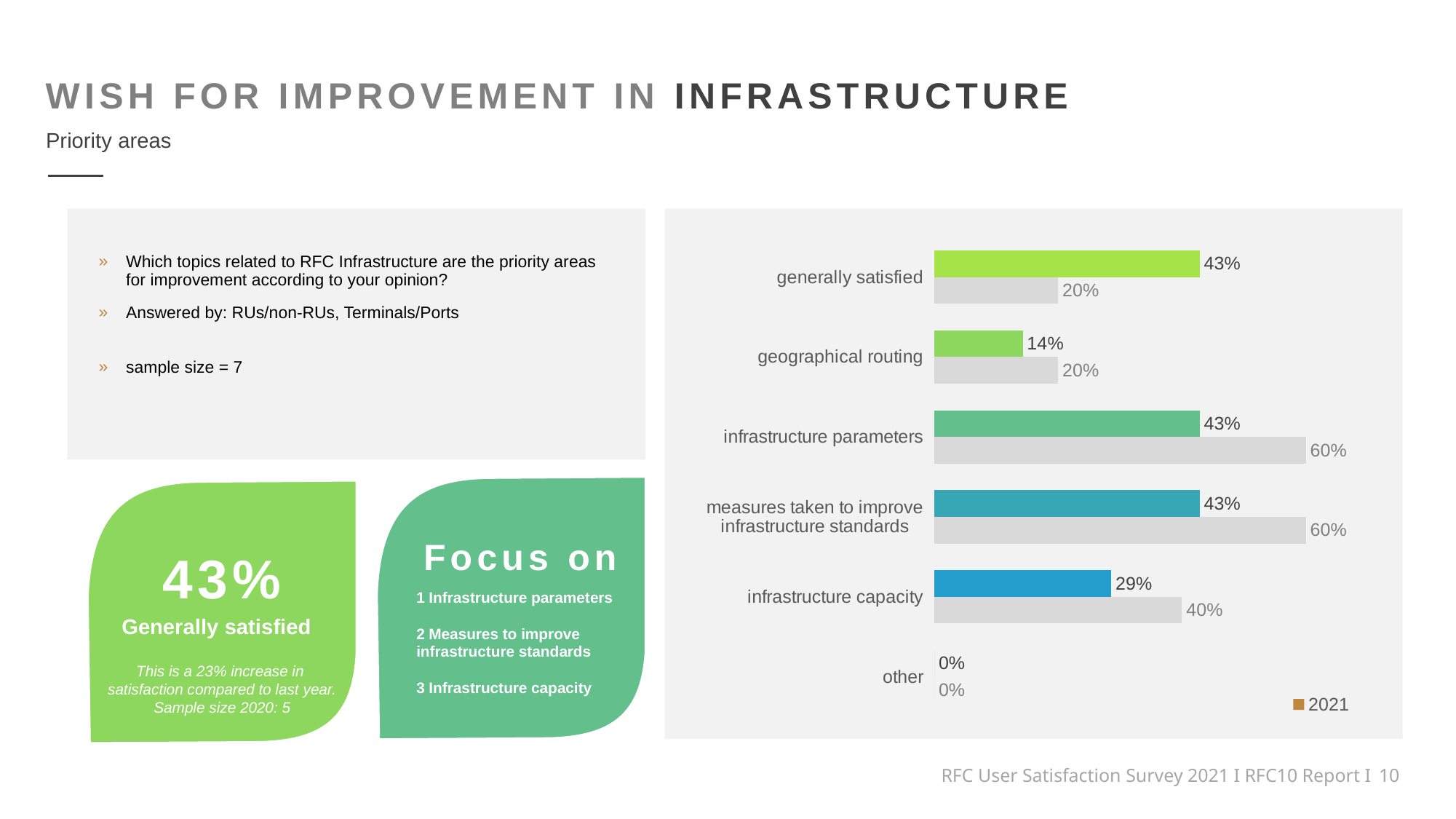
How many series does the legend list? 1 What value is shown on the grey bar for generally satisfied? 20% What is the difference between the 2021 value and the grey bar value for generally satisfied? 23% What is the 2021 value for infrastructure capacity? 29% What value is shown on the grey bar for infrastructure parameters? 60% For geographical routing, which is larger: the 2021 value or the grey bar value? the grey bar value What is the 2021 value for measures taken to improve infrastructure standards? 43% How many categories are shown on the chart? 6 What is the 2021 value for geographical routing? 14% What kind of chart is shown on the slide? bar chart For infrastructure parameters, how much larger is the grey bar value than the 2021 value? 17% Which category has the lowest 2021 value? other